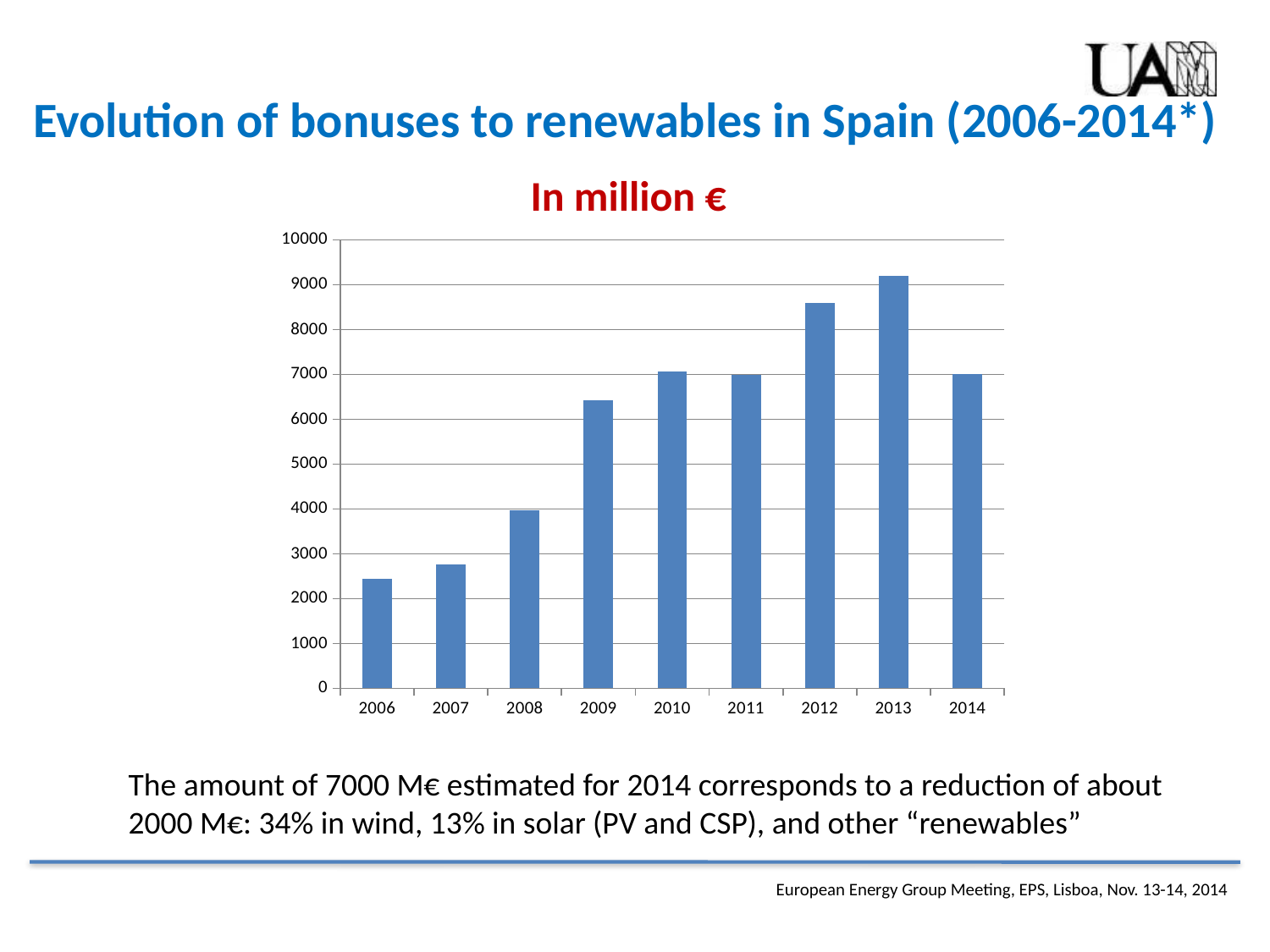
Which year has the highest value in the chart? 2013 Which is larger, the value for 2012 or the value for 2010? 2012 Which year has the lowest value in the chart? 2006 Is the value for 2006 greater or less than 3000? less Do the values rise or fall from 2006 to 2013? rise What is the value for 2014 in the chart, in million €? 7000 Is the value for 2009 greater or less than 6000? greater What kind of chart is shown on the slide? bar chart How many years are plotted on the x axis of the chart? 9 Is the value for 2013 greater or less than 9000? greater What unit does the chart title say the values are in? million €